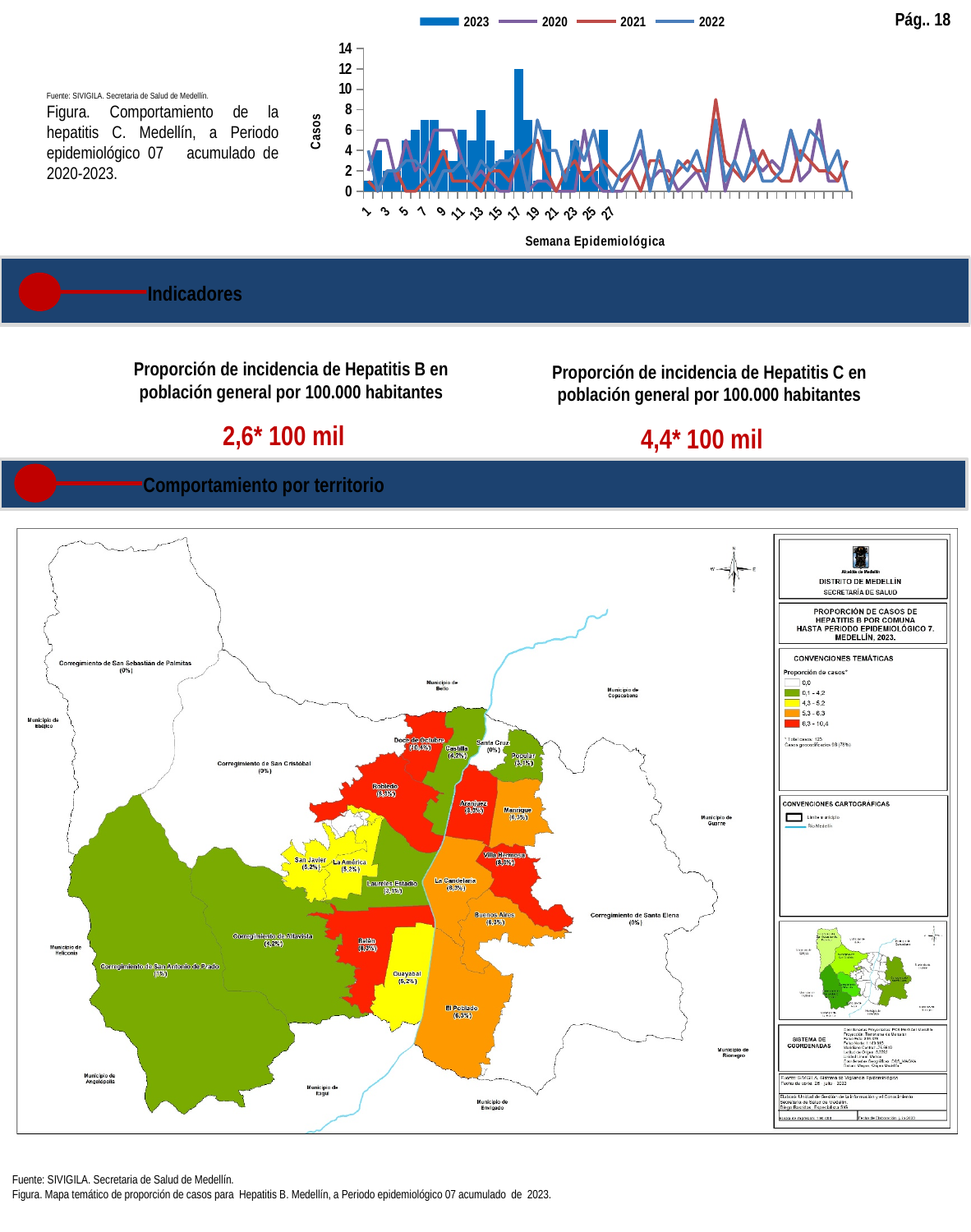
Is the 2023 value for epidemiological week 21 greater or less than 6? less Which series in the hepatitis C chart is drawn as bars rather than a line? 2023 What kind of chart is used to show the hepatitis C cases by epidemiological week? bar and line chart Is the 2023 value for epidemiological week 13 greater or less than 6? greater Is the highest peak of the 2021 line greater or less than 6 cases? greater In which epidemiological week does the 2023 series reach its highest number of cases? 17 At epidemiological week 17, which series has more cases, 2023 or 2020? 2023 What is the label of the vertical axis of the hepatitis C chart? Casos How many series does the legend of the hepatitis C chart list? 4